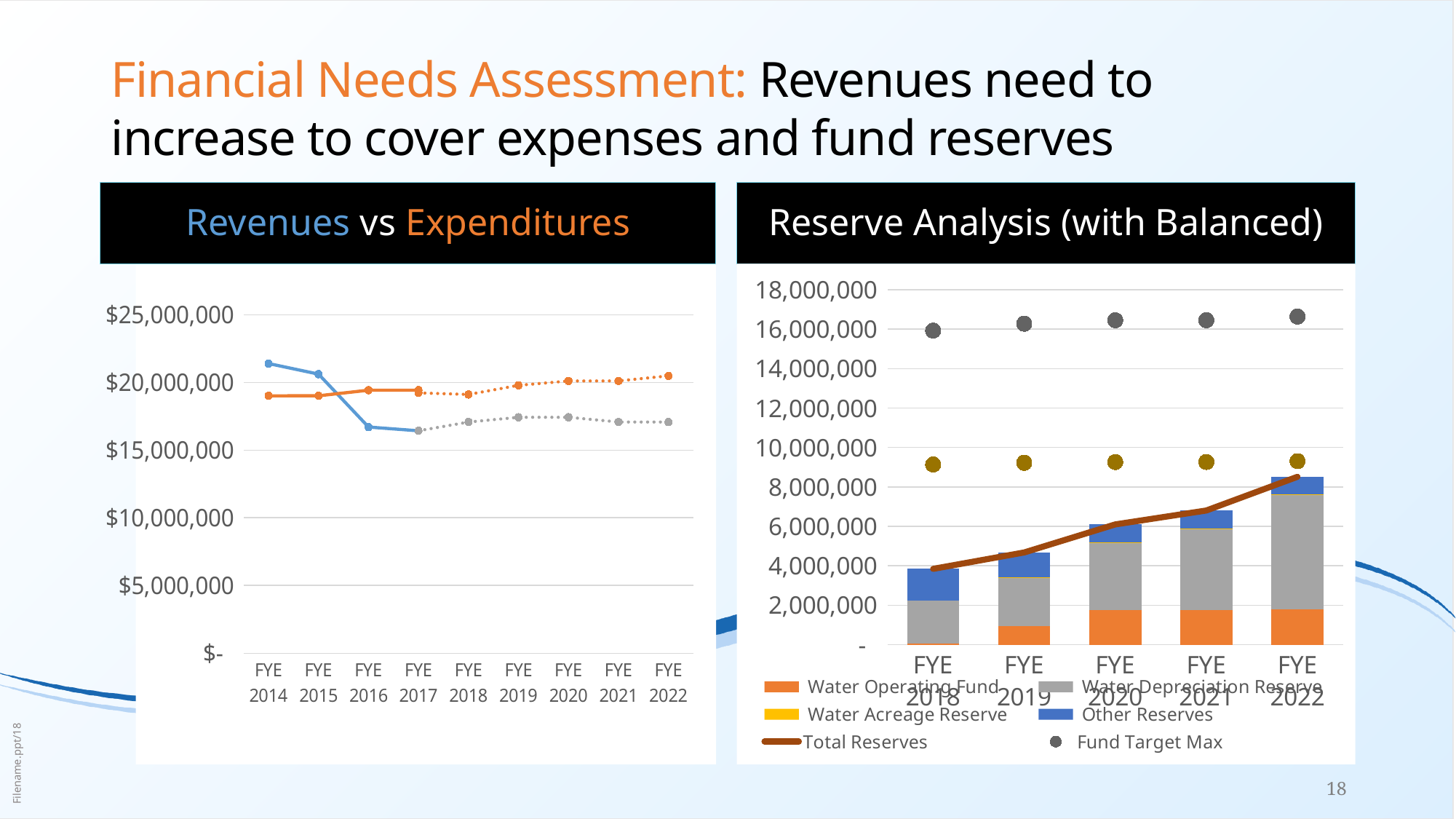
In the Reserve Analysis (with Balanced) chart, which fiscal year has the shortest stacked bar? FYE 2018 In the Revenues vs Expenditures chart, which is larger in FYE 2014, revenues or expenditures? revenues How many series does the legend of the Reserve Analysis (with Balanced) chart list? 6 In the Revenues vs Expenditures chart, is the revenue value for FYE 2014 greater or less than $20,000,000? greater In the Revenues vs Expenditures chart, do revenues rise or fall from FYE 2014 to FYE 2017? fall In the Reserve Analysis (with Balanced) chart, does the Total Reserves line rise or fall from FYE 2018 to FYE 2022? rise How many fiscal years are shown on the x axis of the Revenues vs Expenditures chart? 9 In the Reserve Analysis (with Balanced) chart, is the Fund Target Max value for FYE 2018 greater or less than 14,000,000? greater What kind of chart is the Revenues vs Expenditures chart on the left? line chart In the Reserve Analysis (with Balanced) chart, which fiscal year has the tallest stacked bar? FYE 2022 In the Revenues vs Expenditures chart, is the expenditures value for FYE 2014 greater or less than $20,000,000? less In the Revenues vs Expenditures chart, which is larger in FYE 2022, revenues or expenditures? expenditures